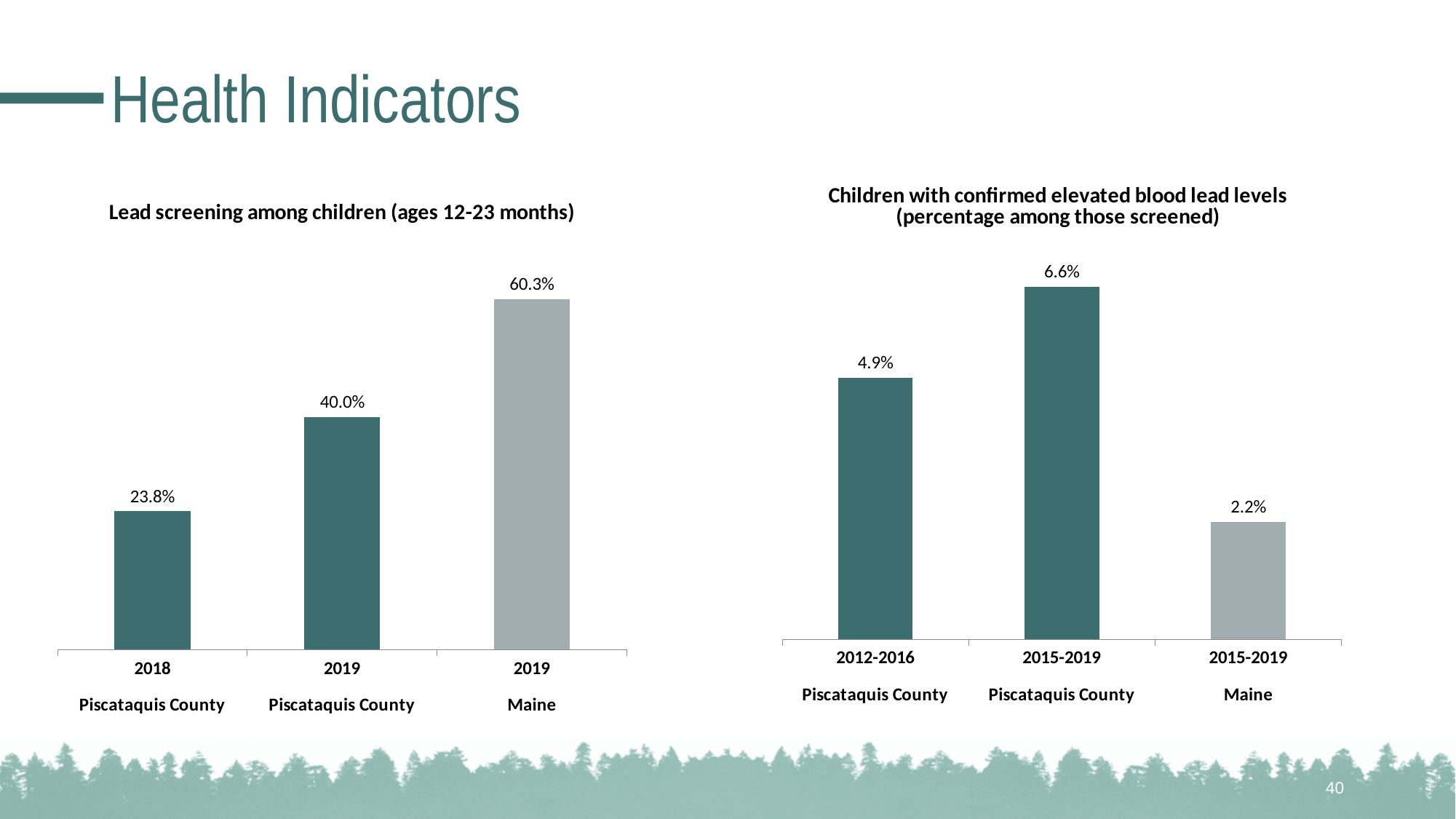
In the 'Lead screening among children (ages 12-23 months)' chart, how many bars are shown? 3 In the 'Children with confirmed elevated blood lead levels' chart, which bar is the lowest? Maine 2015-2019 In the 'Lead screening among children (ages 12-23 months)' chart, which bar is the highest? Maine 2019 In the 'Lead screening among children (ages 12-23 months)' chart, what is the difference between Piscataquis County in 2019 and Piscataquis County in 2018? 16.2% In the 'Children with confirmed elevated blood lead levels' chart, what is the value for Maine in 2015-2019? 2.2% In the 'Lead screening among children (ages 12-23 months)' chart, did the Piscataquis County value rise or fall from 2018 to 2019? rise What type of chart is the 'Children with confirmed elevated blood lead levels' chart? bar chart In the 'Children with confirmed elevated blood lead levels' chart, which is larger: Piscataquis County 2012-2016 or Piscataquis County 2015-2019? Piscataquis County 2015-2019 In the 'Children with confirmed elevated blood lead levels' chart, what is the difference between Piscataquis County 2015-2019 and Maine 2015-2019? 4.4% In the 'Lead screening among children (ages 12-23 months)' chart, what is the value for Maine in 2019? 60.3% In the 'Lead screening among children (ages 12-23 months)' chart, what is the value for Piscataquis County in 2018? 23.8% In the 'Children with confirmed elevated blood lead levels' chart, what is the value for Piscataquis County in 2015-2019? 6.6%